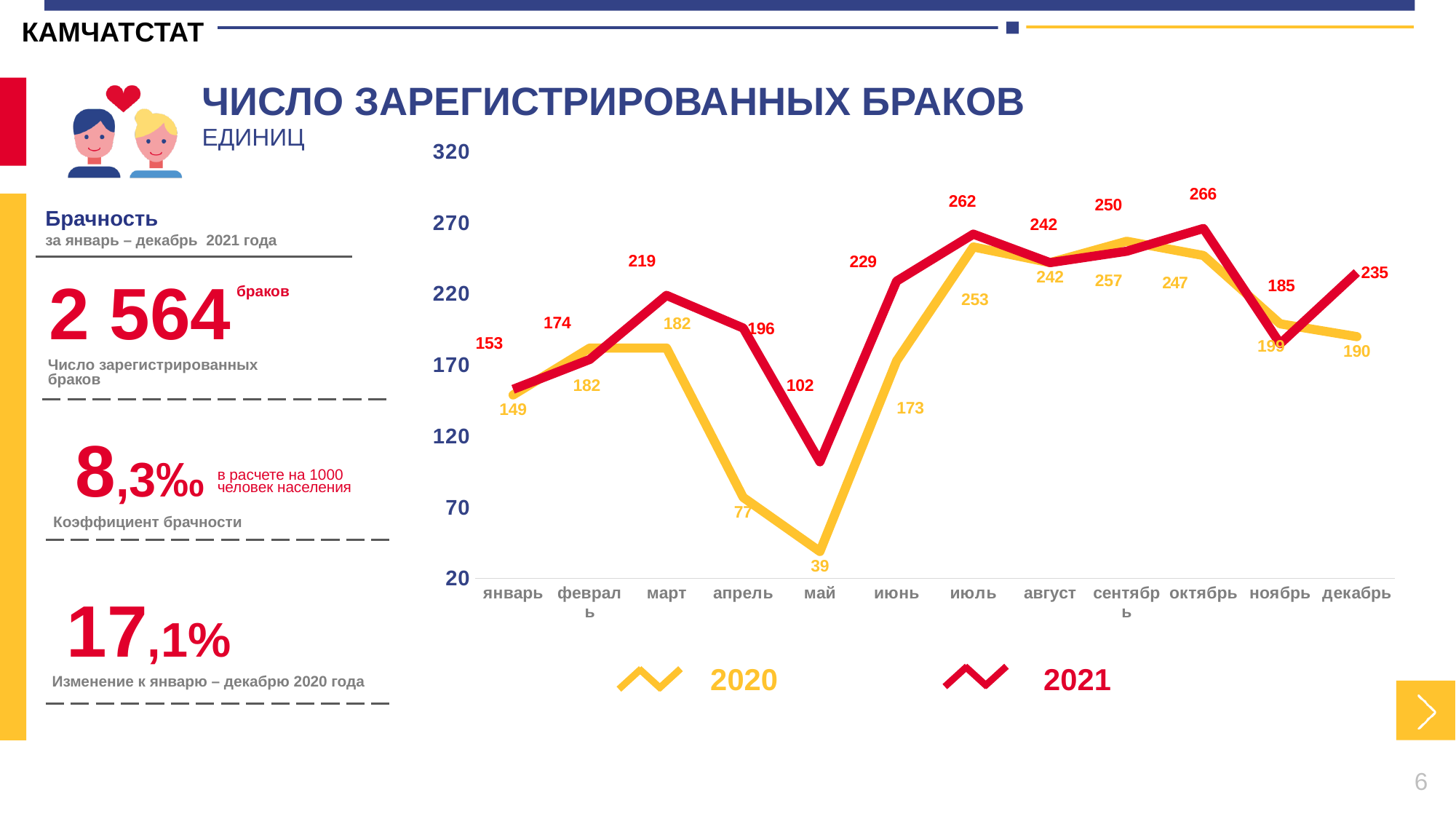
What kind of chart is shown on the slide? line chart What is the value for апрель (April) in the 2021 series? 196 What is the difference between the 2021 and 2020 values for апрель (April)? 119 What is the value for май (May) in the 2020 series? 39 How many months are plotted along the x axis? 12 Which month has the highest value in the 2020 series? сентябрь Which series has the larger value for декабрь (December), 2020 or 2021? 2021 How many series does the legend list? 2 Which month has the lowest value in the 2021 series? май Which colour is used for the 2021 series line? red What is the value for октябрь (October) in the 2021 series? 266 Is the value for май (May) in the 2021 series greater or less than 120? less